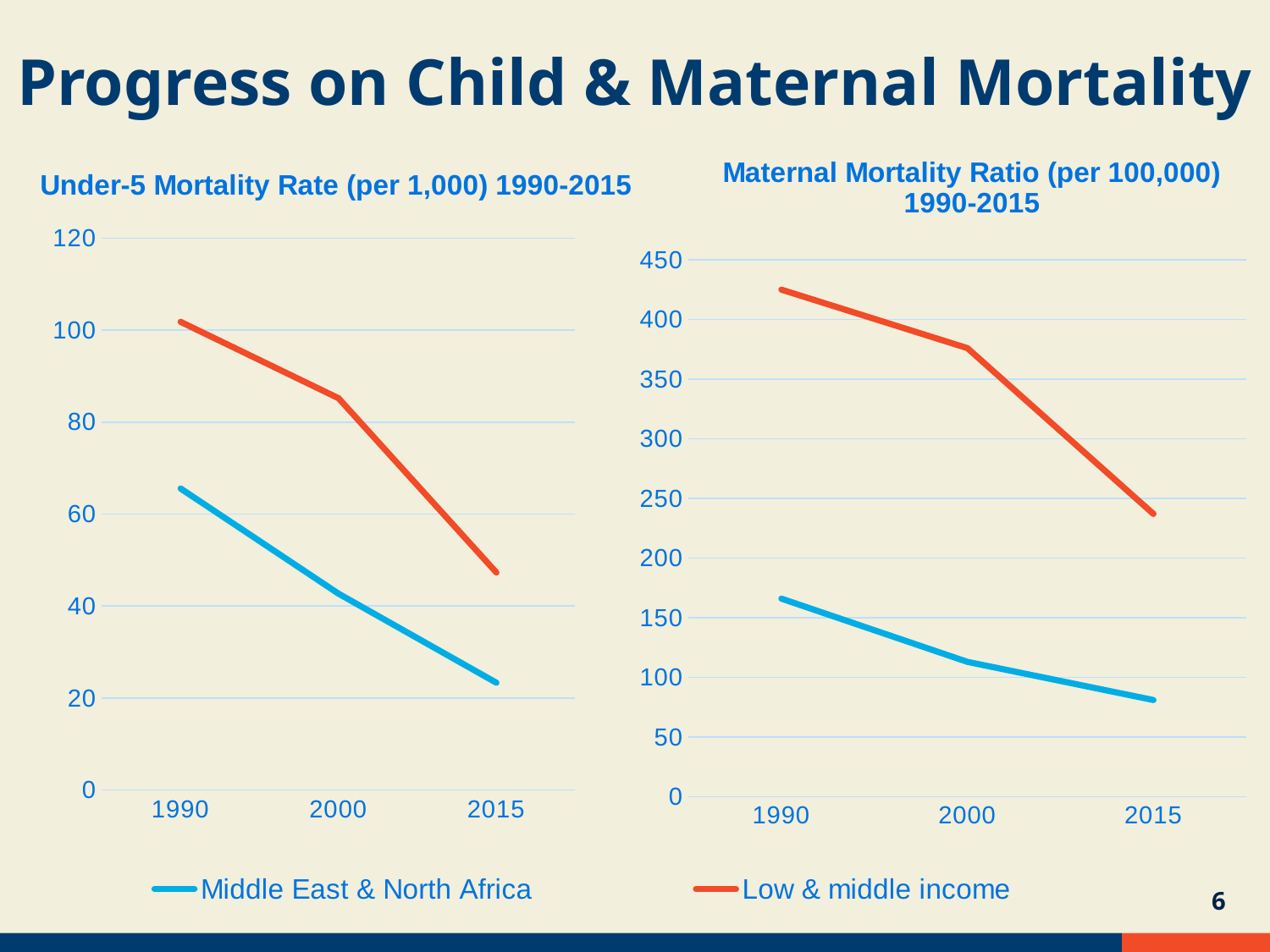
In the Maternal Mortality Ratio (per 100,000) 1990-2015 chart, is the value for Low & middle income in 2000 greater or less than 350? greater In the Maternal Mortality Ratio (per 100,000) 1990-2015 chart, how many years are plotted on the x axis? 3 In the Maternal Mortality Ratio (per 100,000) 1990-2015 chart, is the value for Middle East & North Africa in 2015 greater or less than 100? less In the Maternal Mortality Ratio (per 100,000) 1990-2015 chart, does the Middle East & North Africa line rise or fall from 1990 to 2015? fall In the Maternal Mortality Ratio (per 100,000) 1990-2015 chart, is the value for Low & middle income in 1990 greater or less than 400? greater How many series does the legend list for the charts on the slide? 2 Which colour is used for the Middle East & North Africa series in the charts? blue In the Under-5 Mortality Rate (per 1,000) 1990-2015 chart, which series has the larger value in 1990, Middle East & North Africa or Low & middle income? Low & middle income What kind of chart is the Under-5 Mortality Rate (per 1,000) 1990-2015 chart? line chart In the Under-5 Mortality Rate (per 1,000) 1990-2015 chart, does the Low & middle income line rise or fall from 1990 to 2015? fall